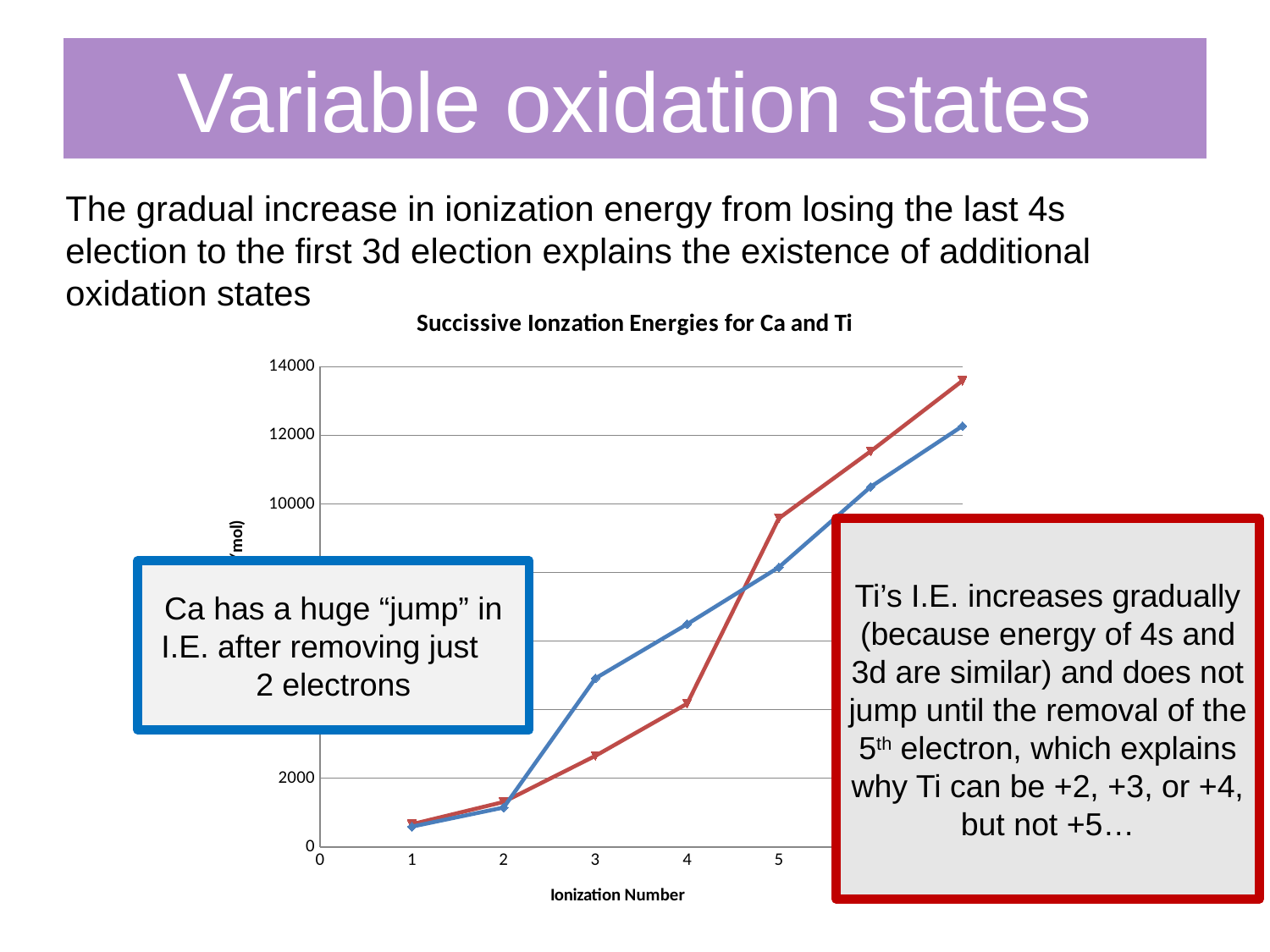
At ionization number 3, which line has the higher value, the blue line or the red line? blue line At ionization number 5, which line has the higher value, the blue line or the red line? red line How many lines are plotted on the chart? 2 What is the title of the chart? Succissive Ionzation Energies for Ca and Ti Is the value of the blue line at ionization number 3 greater or less than 4000? greater Is the value of the red line at ionization number 2 greater or less than 2000? less Is the value of the red line at ionization number 3 greater or less than 4000? less Do the values of the blue line rise or fall as the ionization number increases? rise Do the values of the red line rise or fall as the ionization number increases? rise What is the label on the x axis of the chart? Ionization Number What kind of chart is shown on the slide? line chart